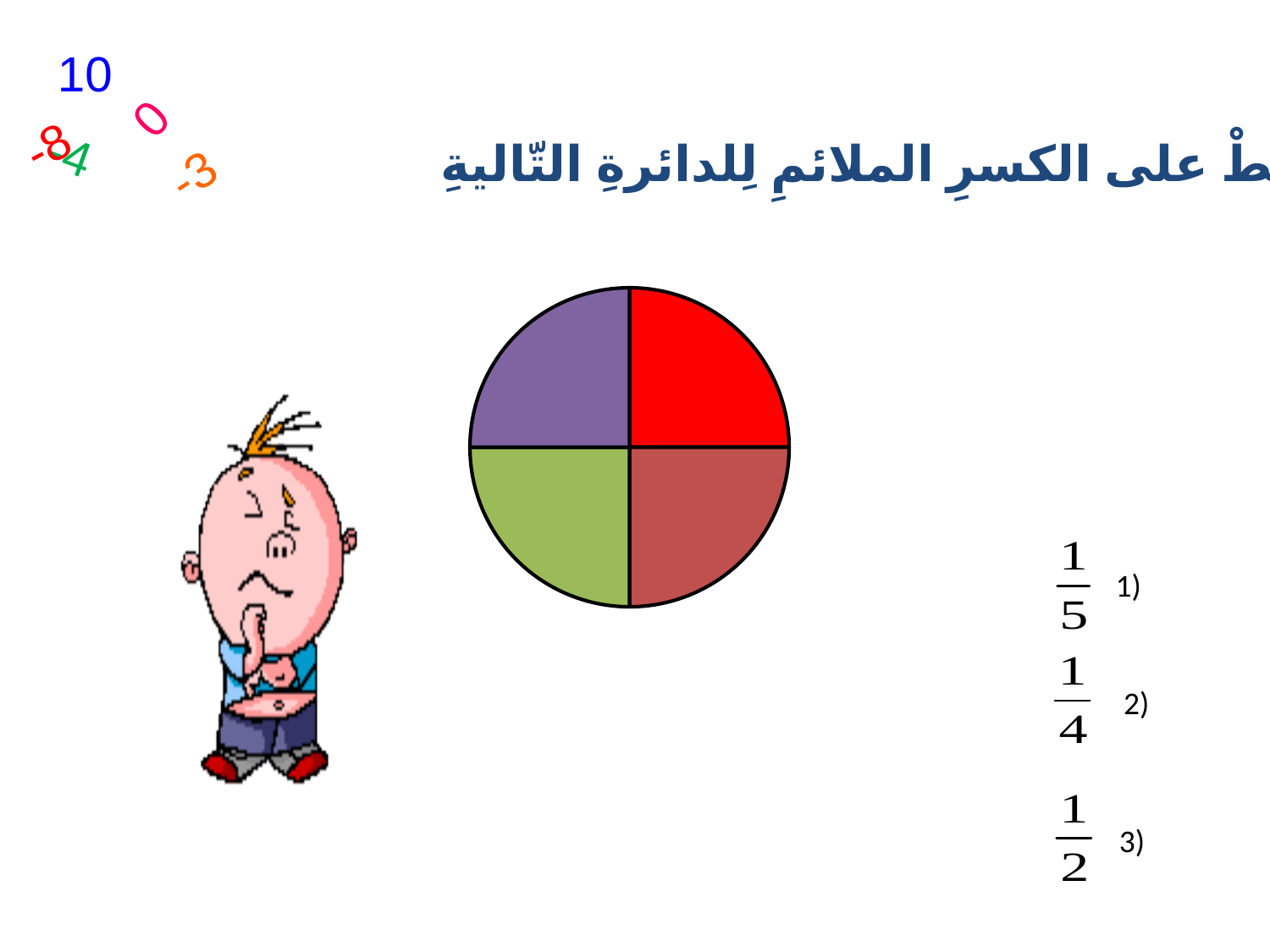
What fraction of the circle does the red slice represent? 1/4 What colour is the top-right slice of the pie chart? red What kind of chart is shown on the slide? pie chart What colour is the bottom-left slice of the pie chart? green How many slices does the pie chart have? 4